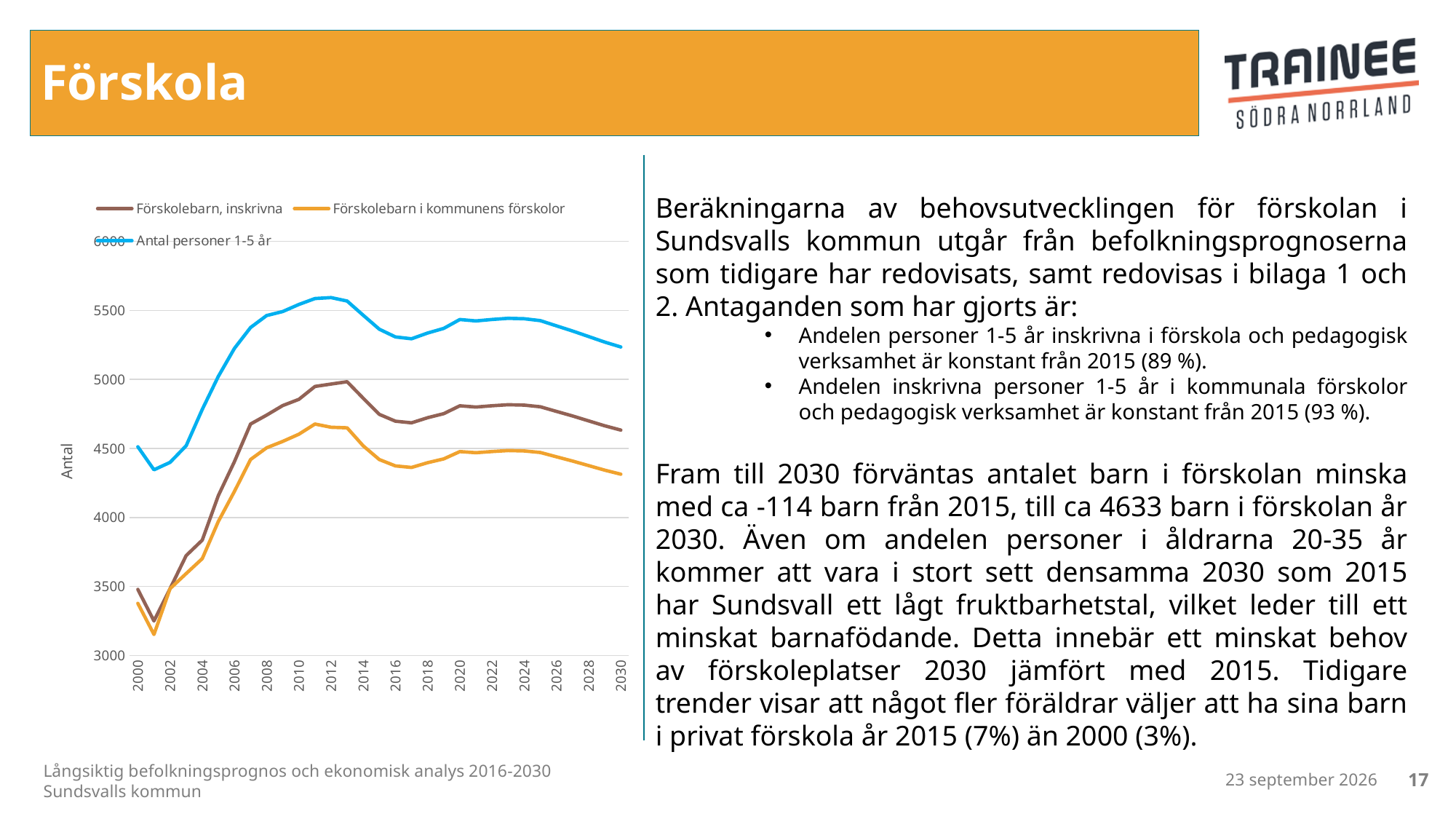
Is the value for Antal personer 1-5 år in 2030 greater or less than 5000? greater Is the value for Förskolebarn i kommunens förskolor in 2030 greater or less than 4500? less Is the value for Antal personer 1-5 år in 2012 greater or less than 5500? greater What is the title of the chart's vertical axis? Antal How many series does the chart's legend list? 3 Which series has the lowest values throughout the chart? Förskolebarn i kommunens förskolor What kind of chart is shown on the slide? line chart Does the Antal personer 1-5 år line rise or fall between 2000 and 2012? rise In 2020, which is larger: Förskolebarn, inskrivna or Förskolebarn i kommunens förskolor? Förskolebarn, inskrivna Do the lines rise or fall between 2024 and 2030? fall Which series has the highest values throughout the chart? Antal personer 1-5 år